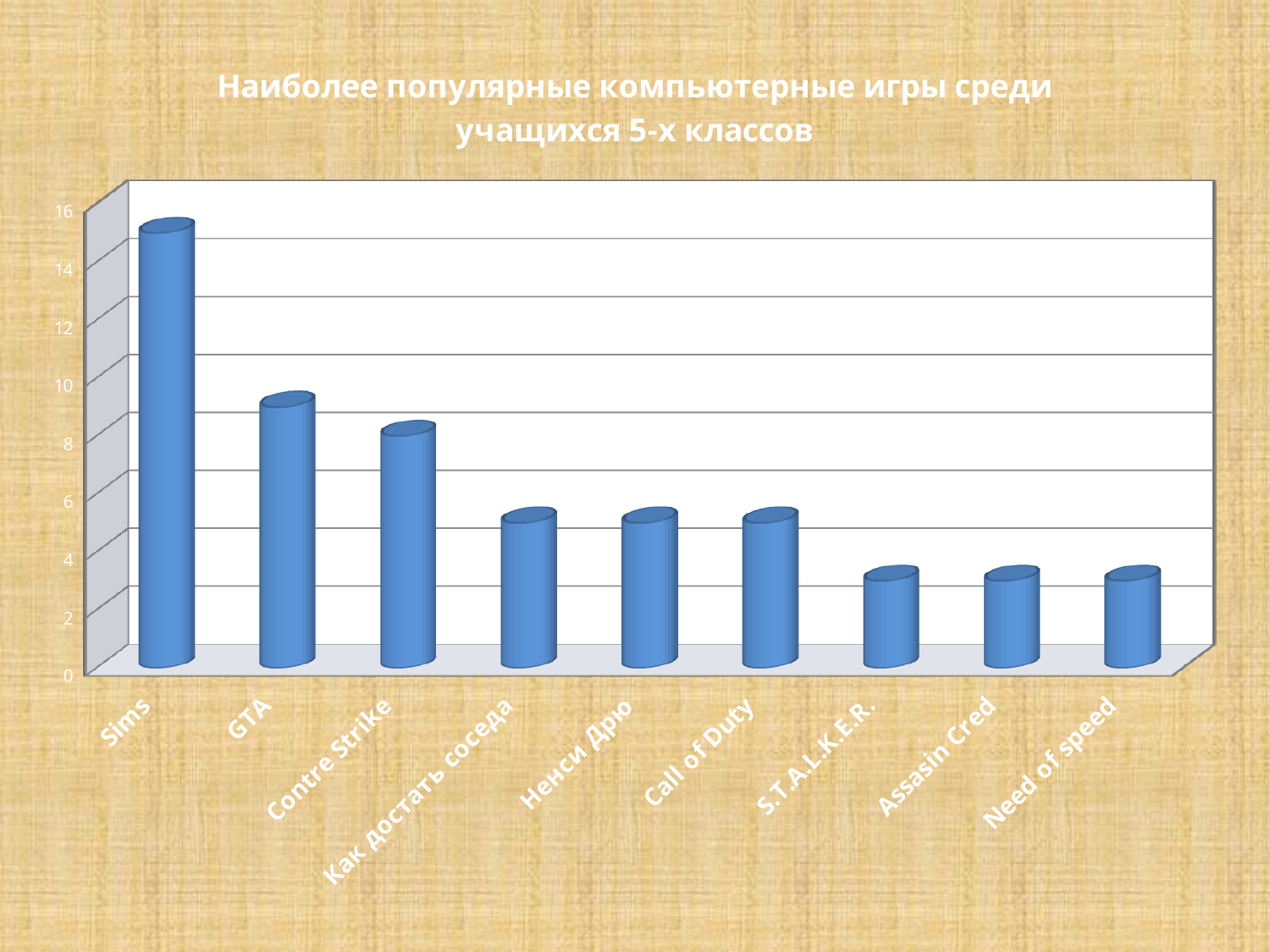
Which is larger, the value for Sims or the value for GTA? Sims Which is larger, the value for GTA or the value for Call of Duty? GTA Is the value for Call of Duty greater or less than 8? less Is the value for S.T.A.L.K.E.R. greater or less than 4? less What kind of chart is shown on the slide? bar chart What is the title of the chart? Наиболее популярные компьютерные игры среди учащихся 5-х классов Is the value for GTA greater or less than 6? greater Which game has the highest bar? Sims Do the bar values generally rise or fall from left to right along the x axis? fall How many games (categories) are shown on the x axis? 9